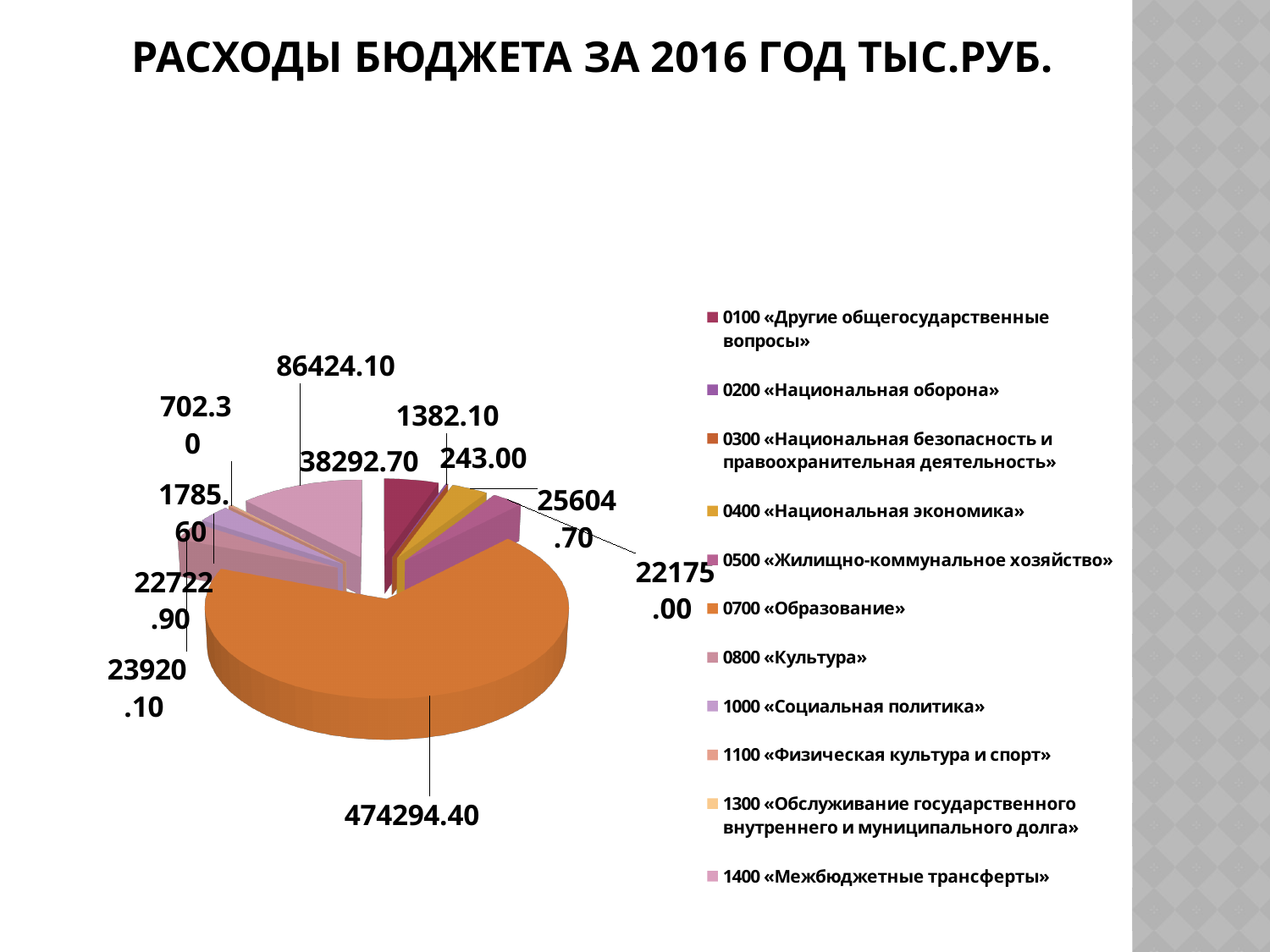
Which category has the largest slice of the pie? 0700 «Образование» What is the largest value printed on the chart? 474294.40 How many categories does the legend list? 11 What is the value for 0700 «Образование»? 474294.40 Which is larger: the slice for 0700 «Образование» or the slice for 1400 «Межбюджетные трансферты»? 0700 «Образование» What is the smallest value printed on the chart? 243.00 What is the title of the chart? РАСХОДЫ БЮДЖЕТА ЗА 2016 ГОД ТЫС.РУБ. How many data labels are printed around the pie? 11 What colour is the slice for 0700 «Образование»? orange What kind of chart is shown on the slide? pie chart What is the difference between the largest and the smallest values printed on the chart? 474051.40 Which legend entry is listed last? 1400 «Межбюджетные трансферты»